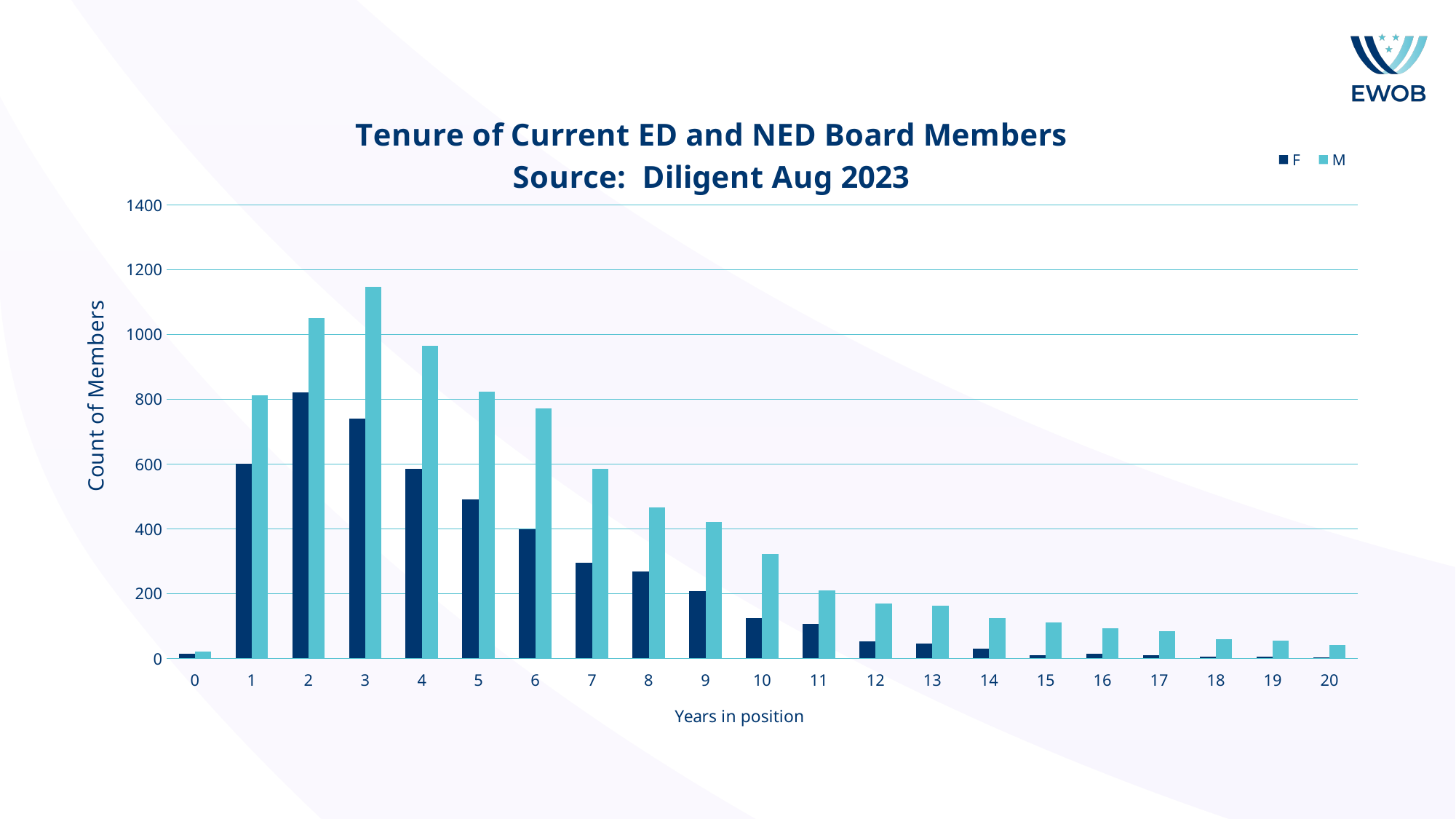
Do the M values rise or fall as years in position increase from 3 to 20? fall How many series does the legend list? 2 Is the value for M at 3 years in position greater or less than 1000? greater Is the value for F at 5 years in position greater or less than 400? greater What is the label of the y axis? Count of Members What kind of chart is shown on the slide? bar chart Which is larger: the M value at 4 years in position or the F value at 2 years in position? M at 4 years Is the value for F at 1 year in position greater or less than 400? greater At which number of years in position is the F series highest? 2 At which number of years in position is the M series highest? 3 How many 'Years in position' categories are shown on the x axis? 21